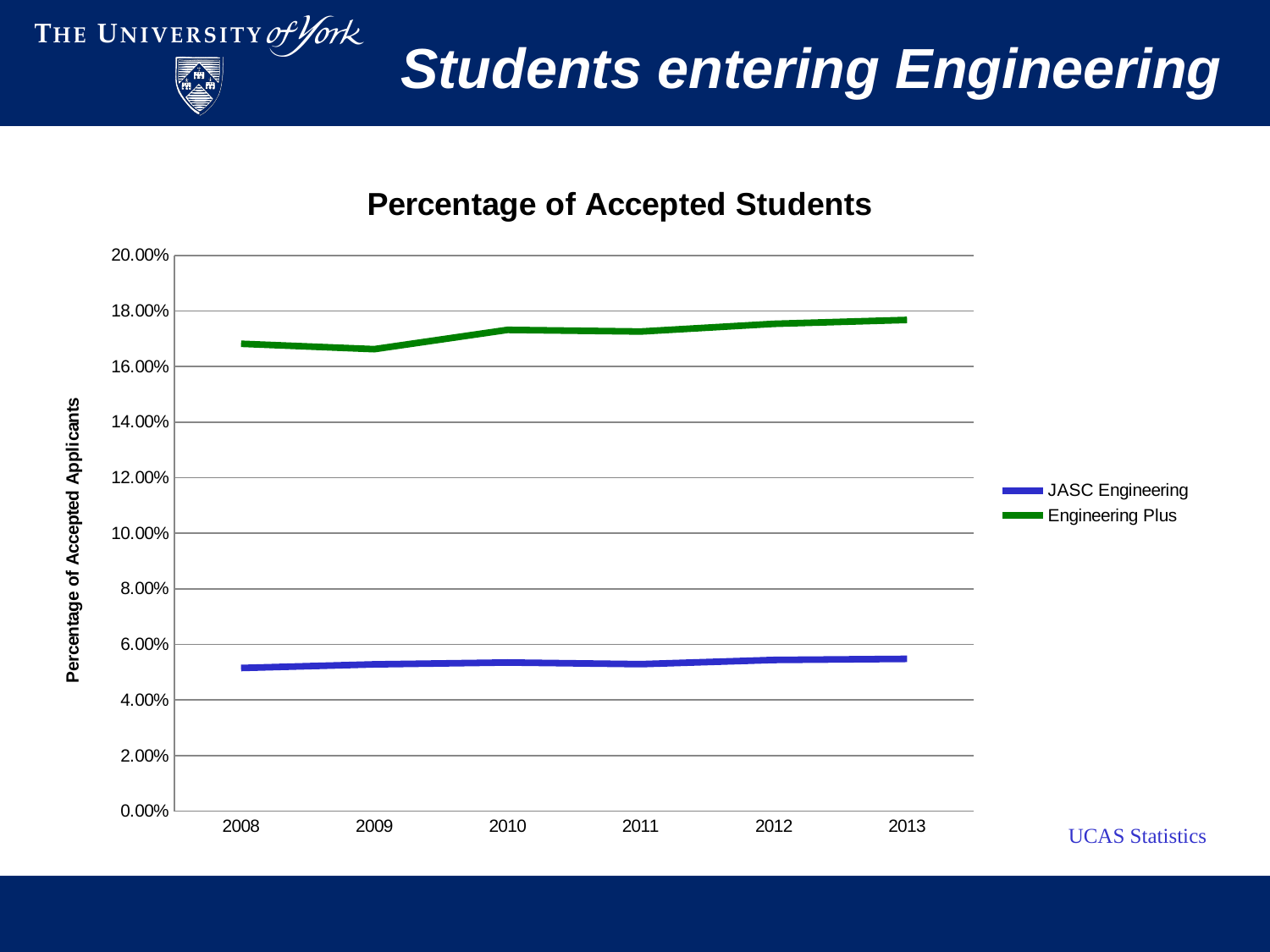
Is the value for JASC Engineering in 2013 greater or less than 4.00%? greater What is the label of the y axis? Percentage of Accepted Applicants Is the value for Engineering Plus in 2009 greater or less than 18.00%? less How many years are shown on the x axis? 6 In which year is the Engineering Plus series at its lowest? 2009 How many series does the legend list? 2 Is the value for Engineering Plus in 2013 greater or less than 16.00%? greater Which series has the higher values across all years, JASC Engineering or Engineering Plus? Engineering Plus In which year is the Engineering Plus series at its highest? 2013 What is the title of the chart? Percentage of Accepted Students What kind of chart is shown on the slide? line chart